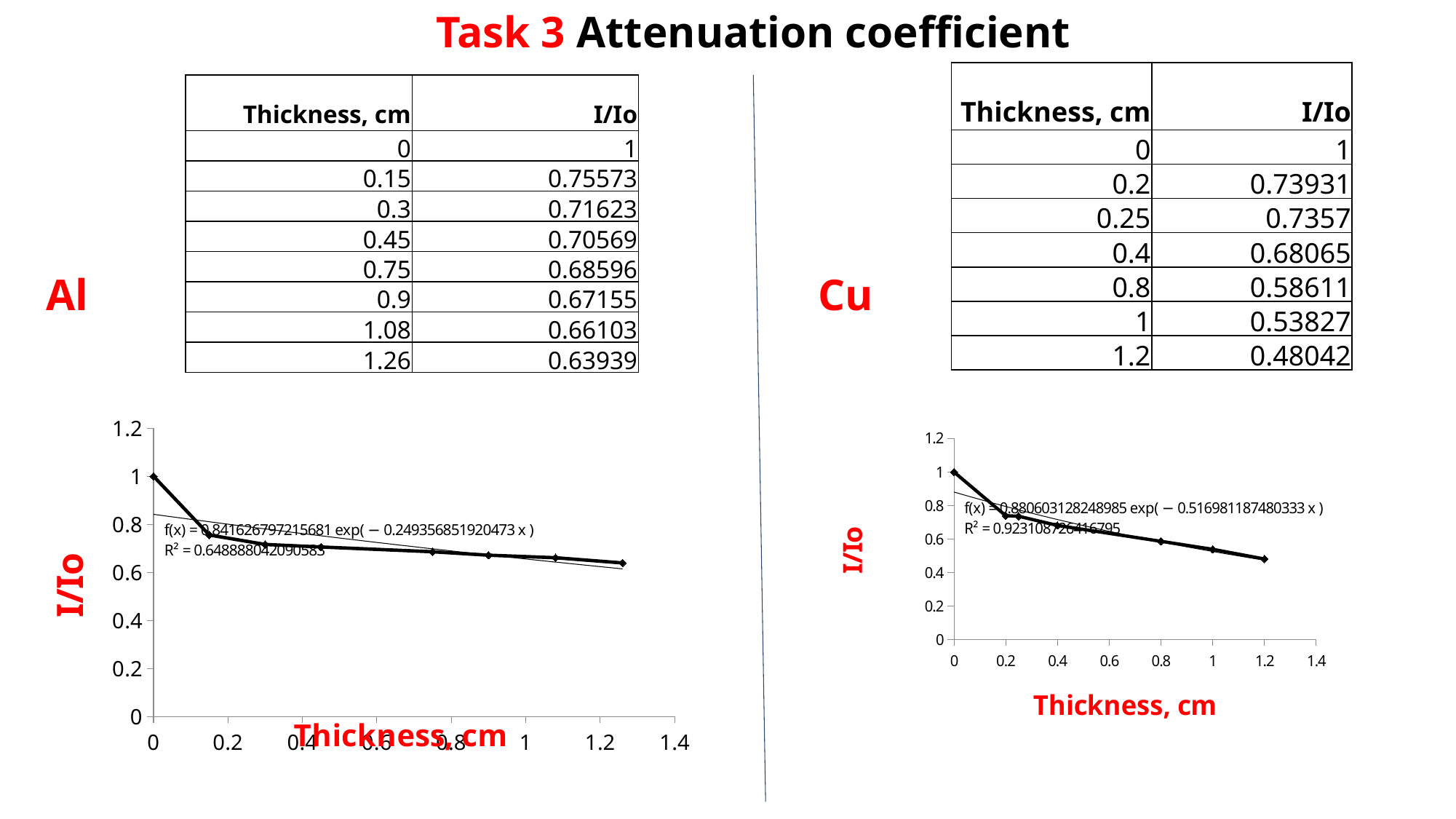
Which is larger: I/Io at 1.26 cm in the Al chart or I/Io at 1.2 cm in the Cu chart? Al at 1.26 cm In the Cu chart, at which thickness is I/Io highest? 0 In the Al chart, at which thickness is I/Io lowest? 1.26 What kind of chart is used for the Cu data? line chart In the Al chart, what is the difference between I/Io at thickness 0 and at thickness 1.26 cm? 0.36061 In the Cu chart, is the I/Io value at 1.2 cm greater or less than 0.6? less How many data points are plotted in the Al chart? 8 In the Al chart, what is the I/Io value at a thickness of 1.26 cm? 0.63939 In the Cu chart, what is the I/Io value at a thickness of 1.2 cm? 0.48042 In the Cu chart, what is the I/Io value at a thickness of 0.8 cm? 0.58611 How many data points are plotted in the Cu chart? 7 In the Al chart, does I/Io rise or fall as thickness increases? fall